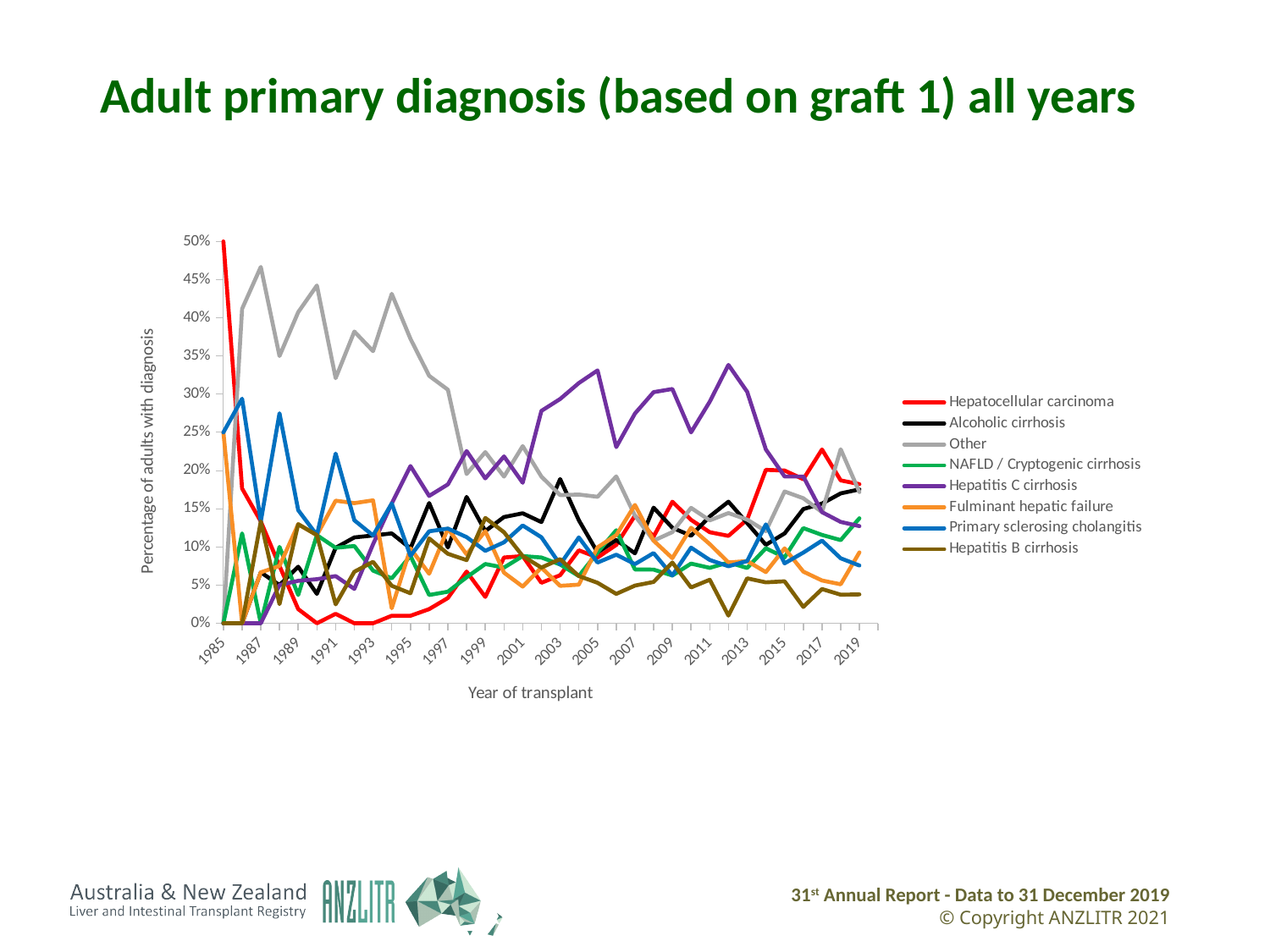
Is the value for Hepatitis C cirrhosis in 1986 greater or less than 5%? less Does the Hepatocellular carcinoma line rise or fall from 1985 to 1991? Fall How many series does the legend list? 8 What kind of chart is shown on the slide? Line chart What is the title of the chart? Adult primary diagnosis (based on graft 1) all years Which series has the lowest value in 2012? Hepatitis B cirrhosis Which series has the highest value in 1988? Other What is the label of the y axis? Percentage of adults with diagnosis Is the value for Other in 1988 greater or less than 40%? less Which series has the highest value in 1985? Hepatocellular carcinoma Is the value for Primary sclerosing cholangitis in 1986 greater or less than 25%? greater Which series has the highest value in 2012? Hepatitis C cirrhosis